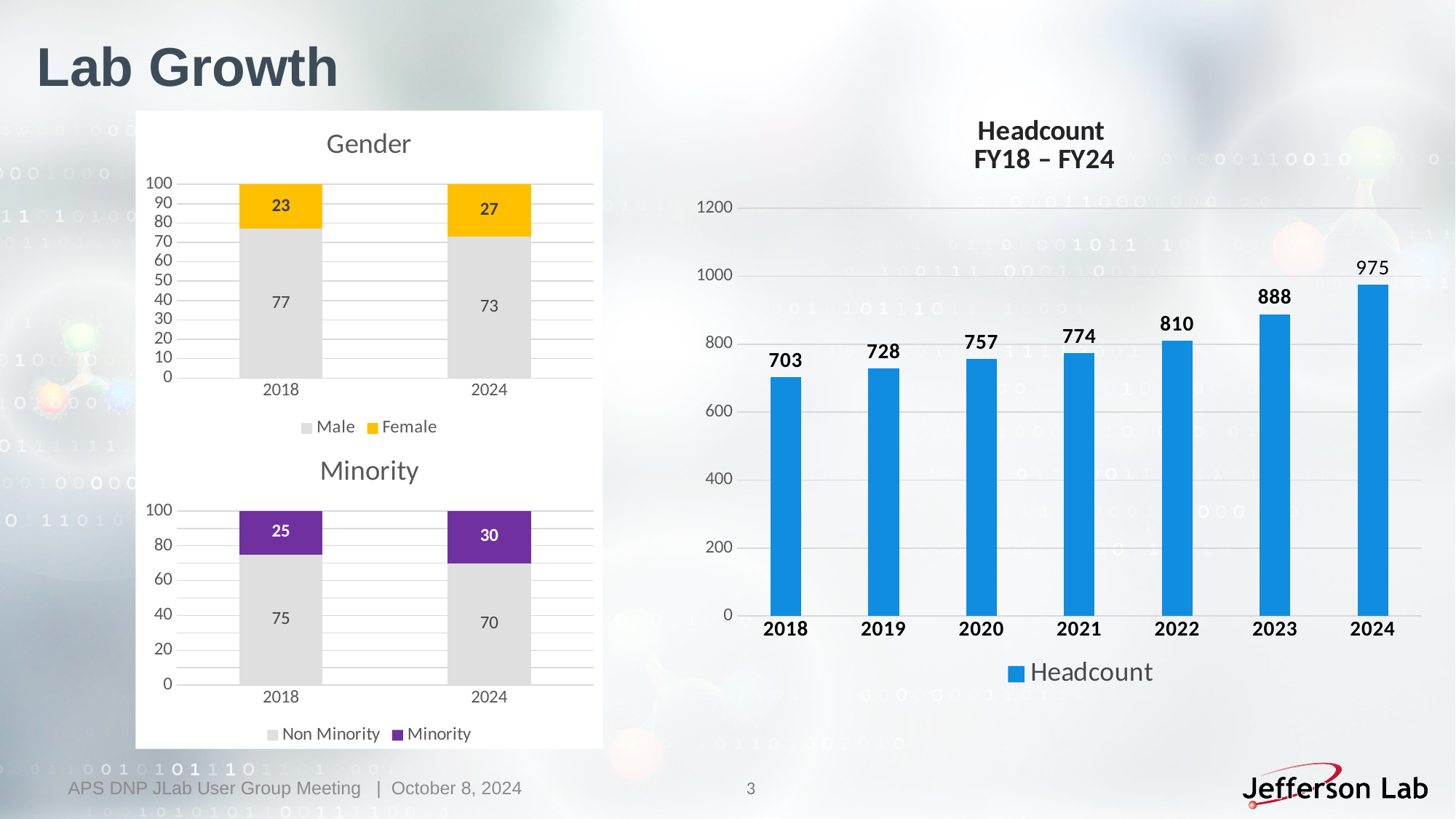
In the Gender chart, what is the Female value for 2024? 27 In the Gender chart, what is the Male value for 2018? 77 In the Headcount FY18 – FY24 chart, what is the difference between the 2024 and 2018 headcounts? 272 In the Minority chart, what is the Minority value for 2024? 30 In the Headcount FY18 – FY24 chart, which year has the lowest headcount? 2018 In the Headcount FY18 – FY24 chart, what is the headcount for 2021? 774 How many series does the legend of the Minority chart list? 2 In the Headcount FY18 – FY24 chart, how many years are shown? 7 In the Headcount FY18 – FY24 chart, do the values rise or fall from 2018 to 2024? rise In the Headcount FY18 – FY24 chart, which year has the highest headcount? 2024 What kind of chart is the Headcount FY18 – FY24 chart? bar chart In the Minority chart, what is the difference between the Minority values for 2024 and 2018? 5